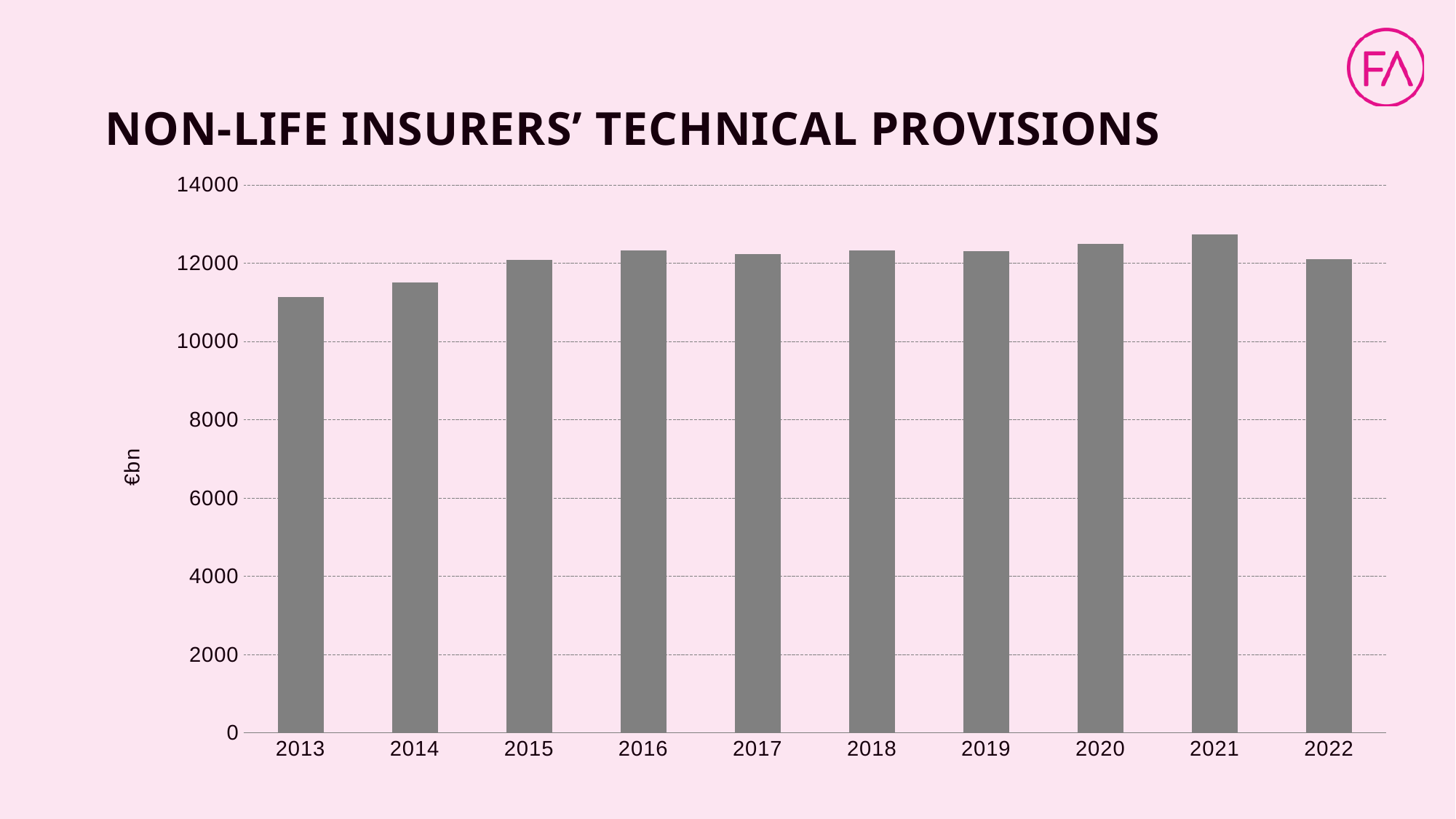
Do the values rise or fall from 2013 to 2016? rise Which year has the lowest technical provisions? 2013 Is the value for 2021 greater or less than 12000? greater Which is larger, the value for 2014 or the value for 2020? 2020 Is the value for 2014 greater or less than 12000? less What is the title of the chart? NON-LIFE INSURERS' TECHNICAL PROVISIONS What unit is shown on the vertical axis of the chart? €bn Is the value for 2013 greater or less than 10000? greater How many years are plotted on the chart? 10 Which year has the highest technical provisions? 2021 What kind of chart is shown on the slide? bar chart